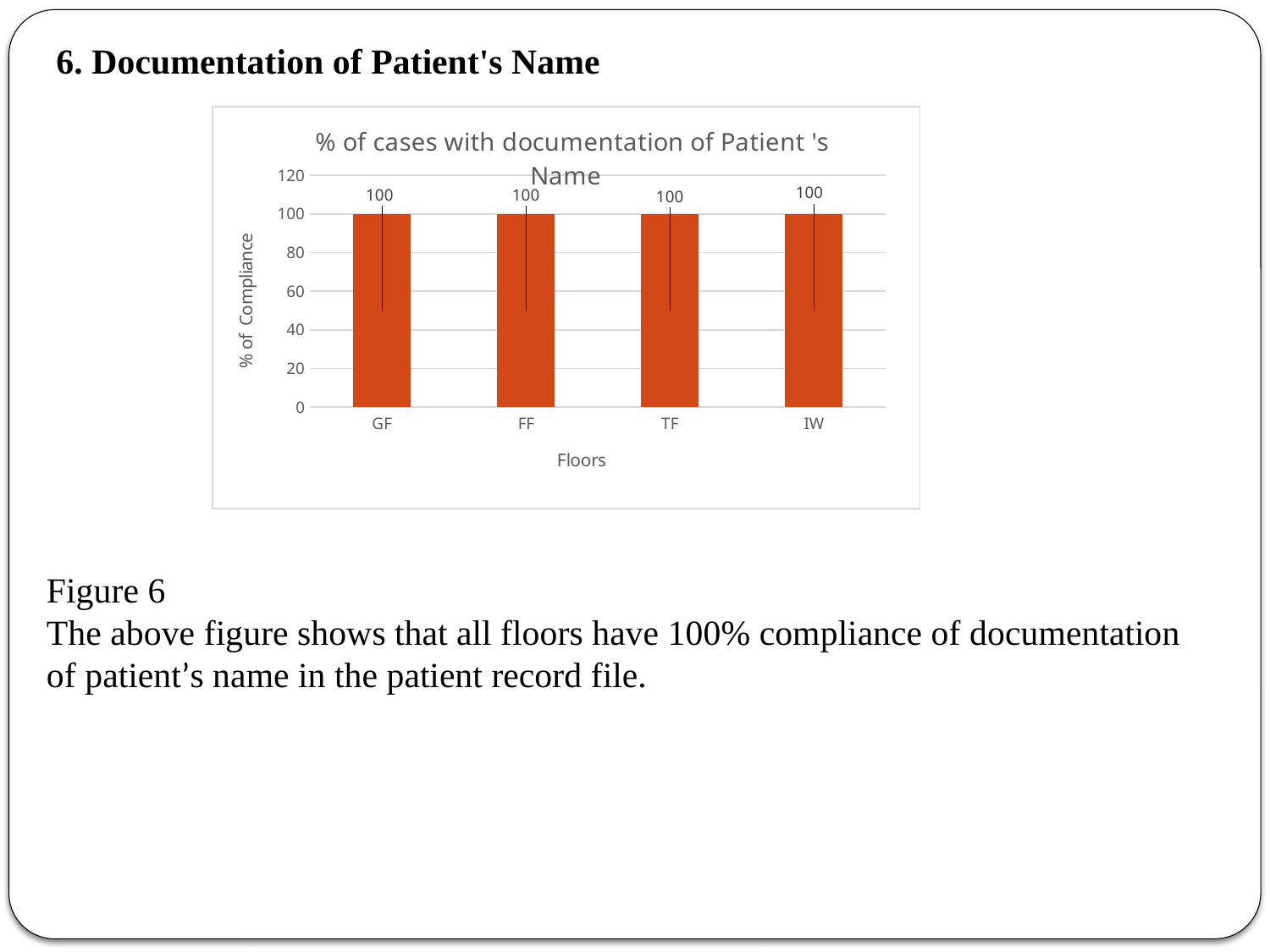
Do the values rise, fall or stay the same from GF to IW? stay the same How many floors are shown on the x axis? 4 What is the difference between the values for GF and IW? 0 What is the value for FF? 100 What kind of chart is shown? bar chart Is the value for FF greater or less than 60? greater Is the value for TF greater or less than 80? greater What is the value for IW? 100 What is the label of the x axis? Floors What is the value for TF? 100 What is the title of the chart? % of cases with documentation of Patient 's Name What is the value for GF? 100